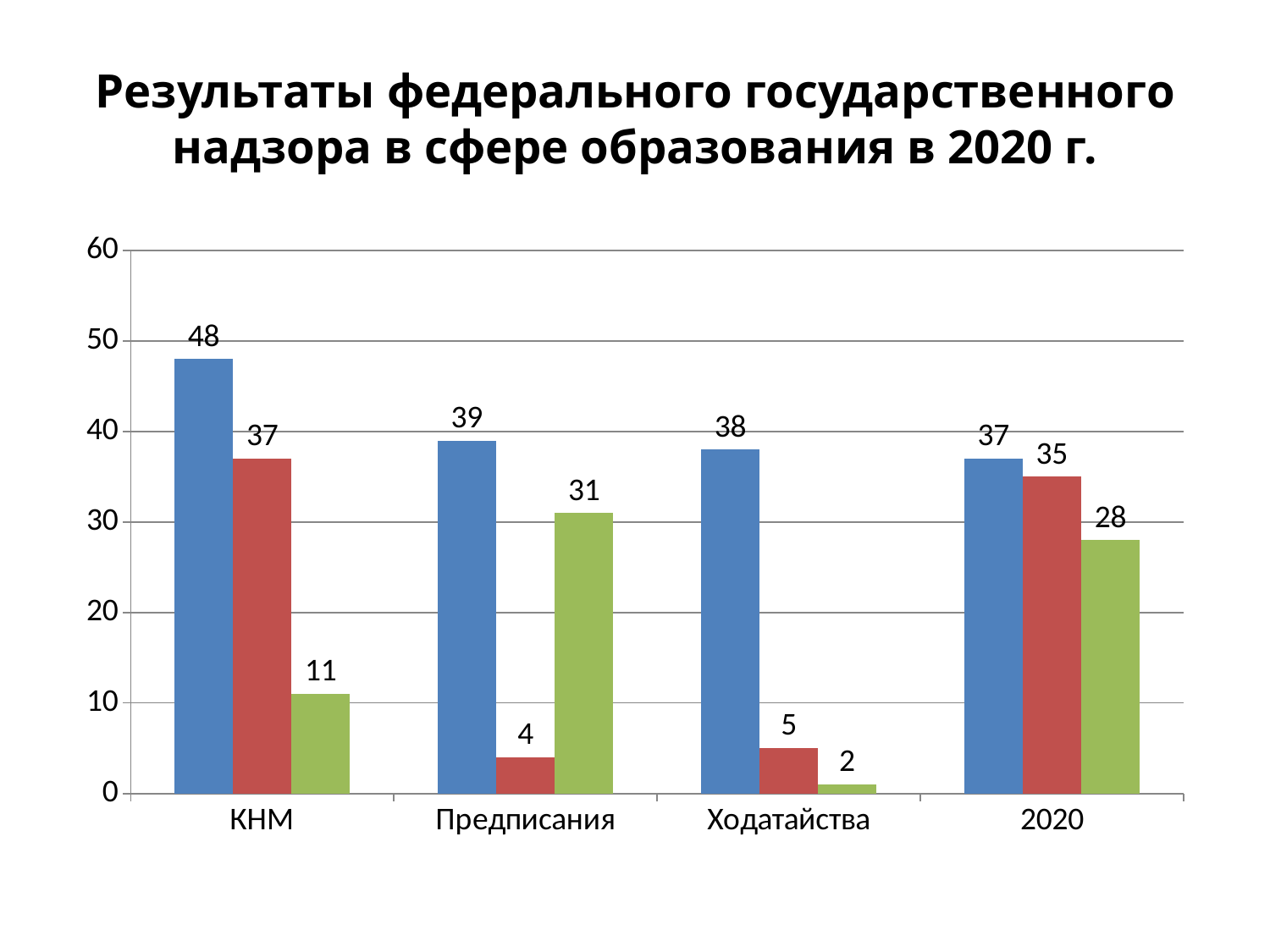
How many categories are shown on the x axis? 4 Which category has the highest blue bar? КНМ What is the value of the blue bar for КНМ? 48 Which is larger for КНМ: the red bar or the green bar? the red bar What is the difference between the blue and red bars for Предписания? 35 What is the value of the red bar for Ходатайства? 5 What is the value of the green bar for Предписания? 31 What is the title of the chart? Результаты федерального государственного надзора в сфере образования в 2020 г. What is the value of the green bar for 2020? 28 Do the blue bars rise or fall from КНМ to 2020? fall What type of chart is shown on the slide? bar chart Which category has the lowest green bar? Ходатайства